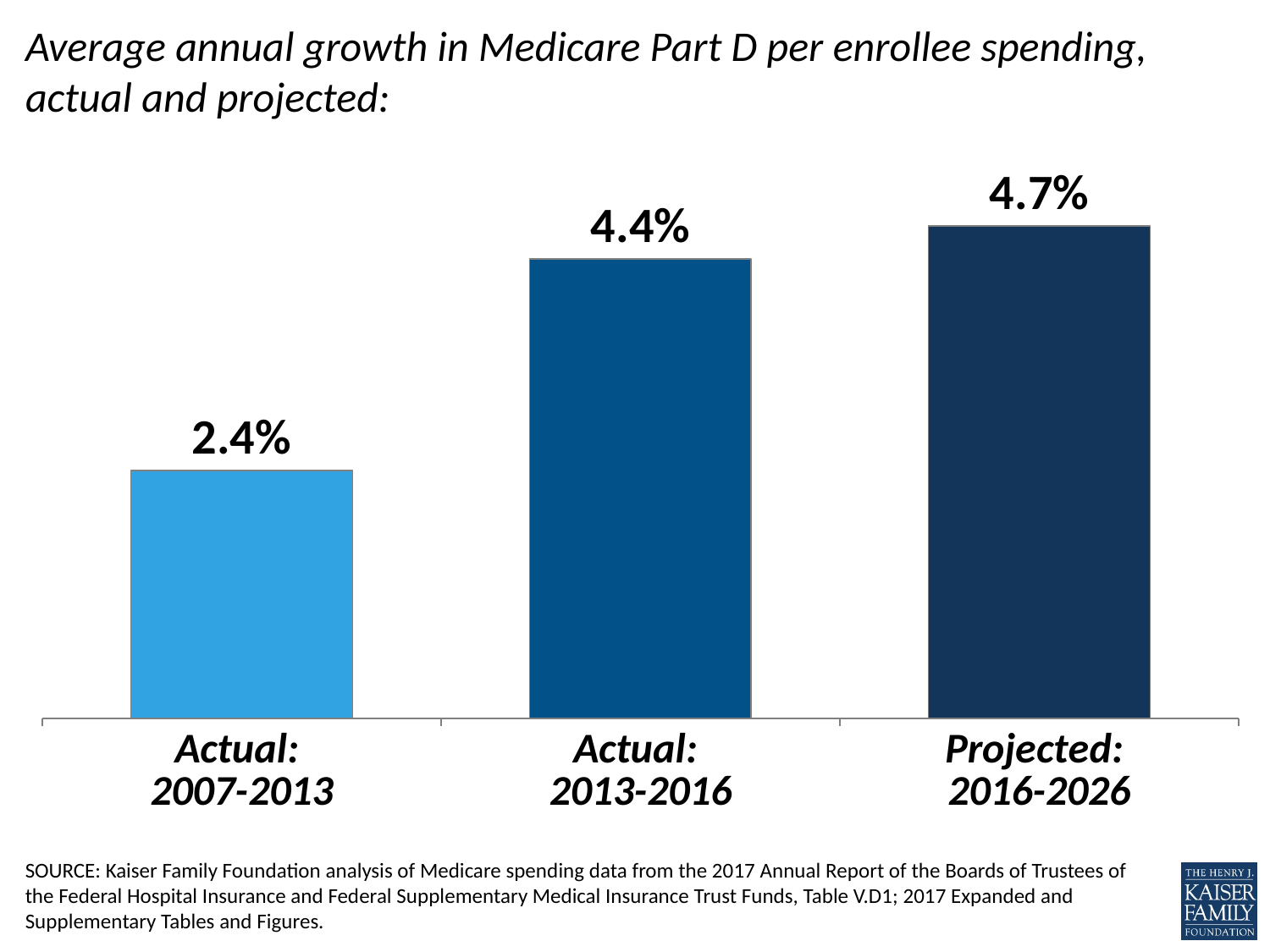
What is the title of the chart? Average annual growth in Medicare Part D per enrollee spending, actual and projected: What is the projected average annual growth in Medicare Part D per enrollee spending for 2016-2026? 4.7% What kind of chart is shown on the slide? Bar chart Which is larger, the average annual growth for Actual: 2007-2013 or for Actual: 2013-2016? Actual: 2013-2016 What is the difference in average annual growth between Projected: 2016-2026 and Actual: 2013-2016? 0.3% How many periods are shown in the chart? 3 What is the average annual growth in Medicare Part D per enrollee spending for Actual: 2013-2016? 4.4% What is the average annual growth in Medicare Part D per enrollee spending for Actual: 2007-2013? 2.4% Do the values rise or fall from left to right across the periods? Rise What is the difference in average annual growth between Actual: 2013-2016 and Actual: 2007-2013? 2.0% Which period has the highest average annual growth in Medicare Part D per enrollee spending? Projected: 2016-2026 Which period has the lowest average annual growth in Medicare Part D per enrollee spending? Actual: 2007-2013